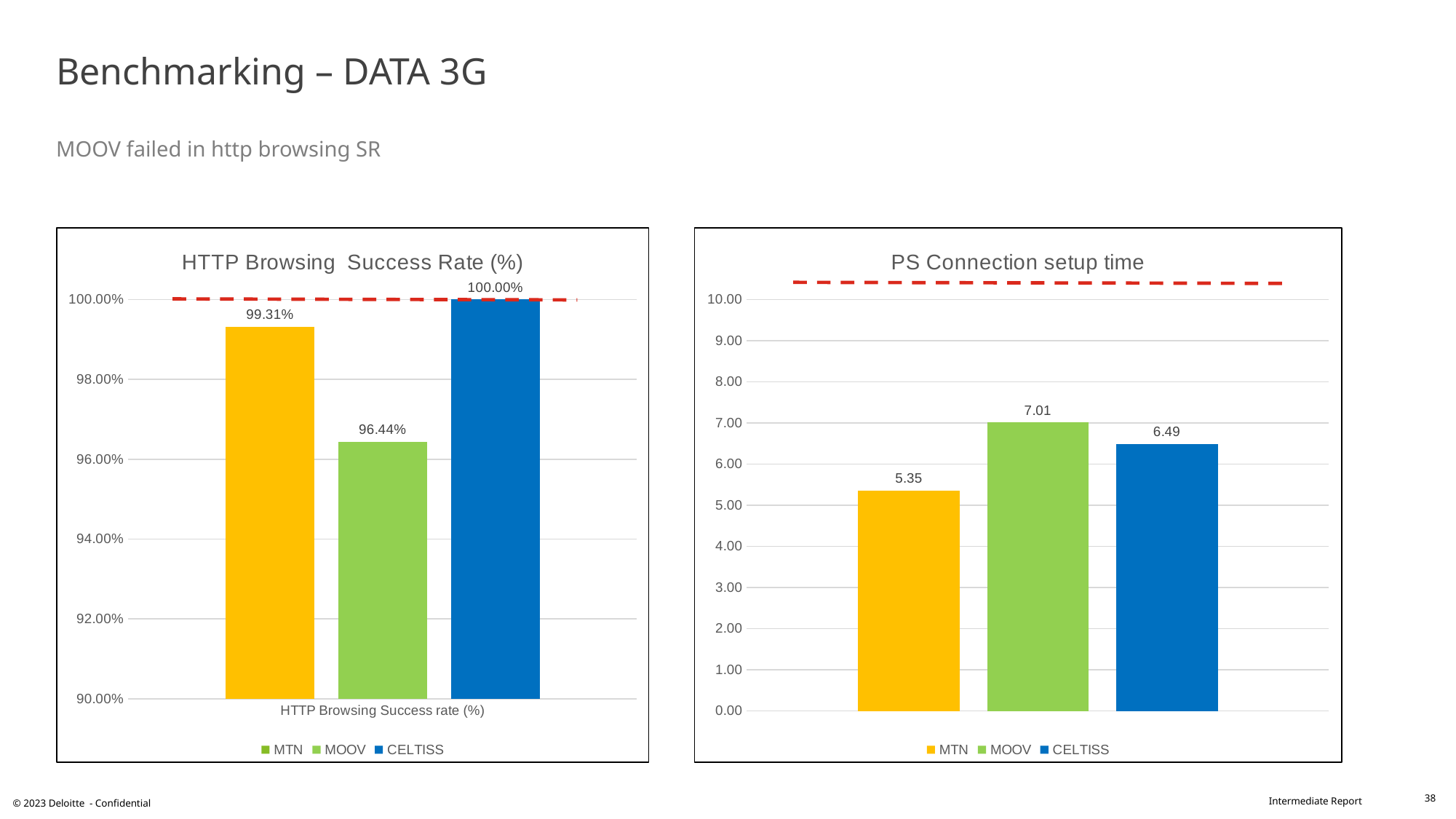
In the HTTP Browsing Success Rate (%) chart, what is the value for MOOV? 96.44% In the PS Connection setup time chart, which operator has the lowest setup time? MTN What kind of chart is the HTTP Browsing Success Rate (%) chart? bar chart In the PS Connection setup time chart, what is the value for MOOV? 7.01 How many series does the legend of the PS Connection setup time chart list? 3 In the HTTP Browsing Success Rate (%) chart, what is the difference between CELTISS and MOOV? 3.56% In the HTTP Browsing Success Rate (%) chart, which operator has the highest success rate? CELTISS In the HTTP Browsing Success Rate (%) chart, which operator has the lowest success rate? MOOV In the HTTP Browsing Success Rate (%) chart, what is the value for MTN? 99.31% In the PS Connection setup time chart, what is the value for CELTISS? 6.49 In the PS Connection setup time chart, what is the difference between MOOV and MTN? 1.66 In the PS Connection setup time chart, is the value for MTN greater or less than 6.00? less